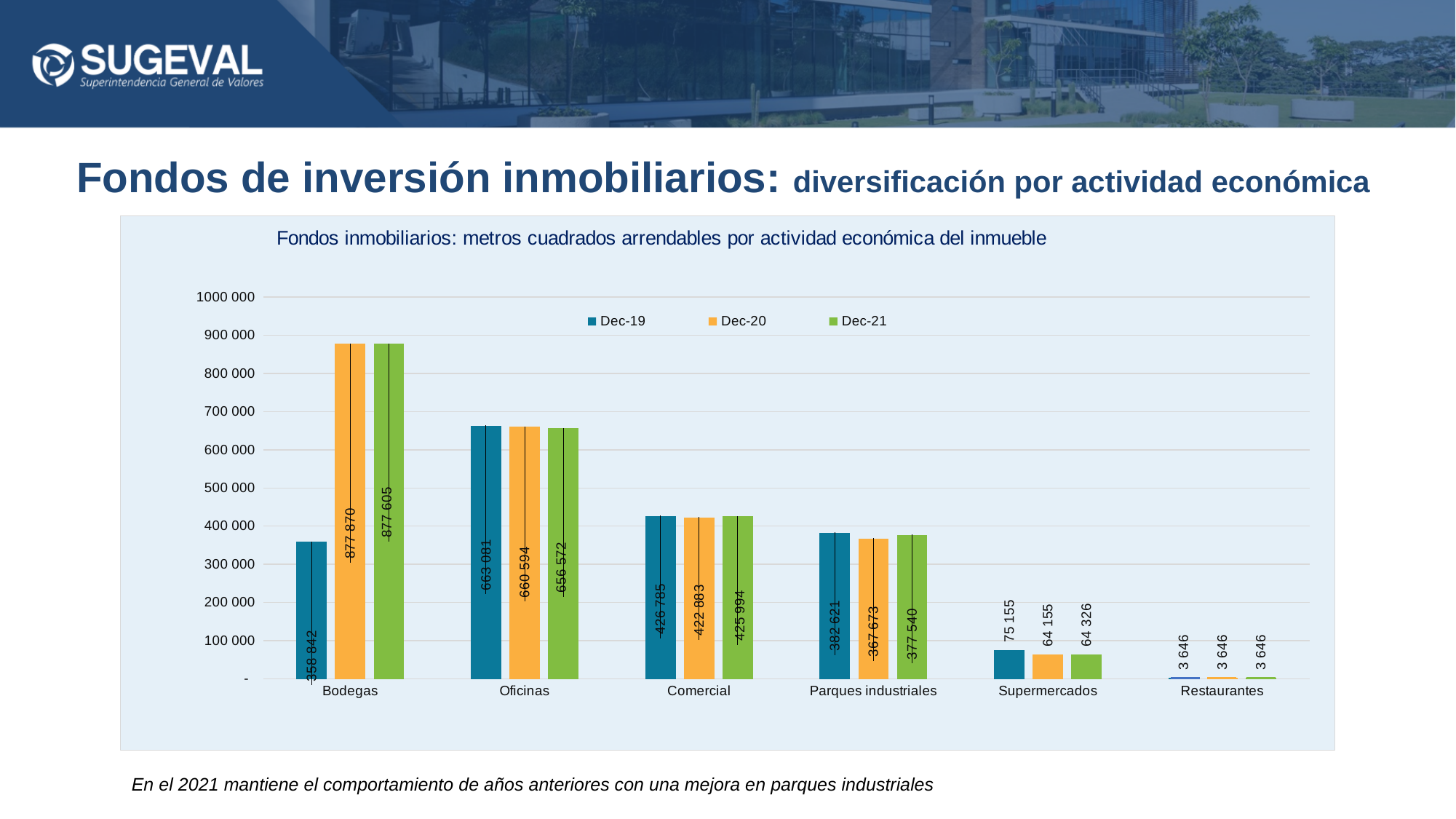
Which category has the highest value in Dec-21? Bodegas How many categories are shown on the x axis? 6 What is the difference between the Dec-20 and Dec-19 values for Bodegas? 519 028 What kind of chart is shown on the slide? Bar chart What is the value for Supermercados in Dec-19? 75 155 What is the difference between the Dec-21 and Dec-20 values for Parques industriales? 9 867 Which category has the lowest value in Dec-19? Restaurantes Which is larger in Dec-19: Bodegas or Oficinas? Oficinas How many series does the legend list? 3 What is the value for Oficinas in Dec-21? 656 572 What is the value for Restaurantes in Dec-21? 3 646 What is the value for Bodegas in Dec-20? 877 870